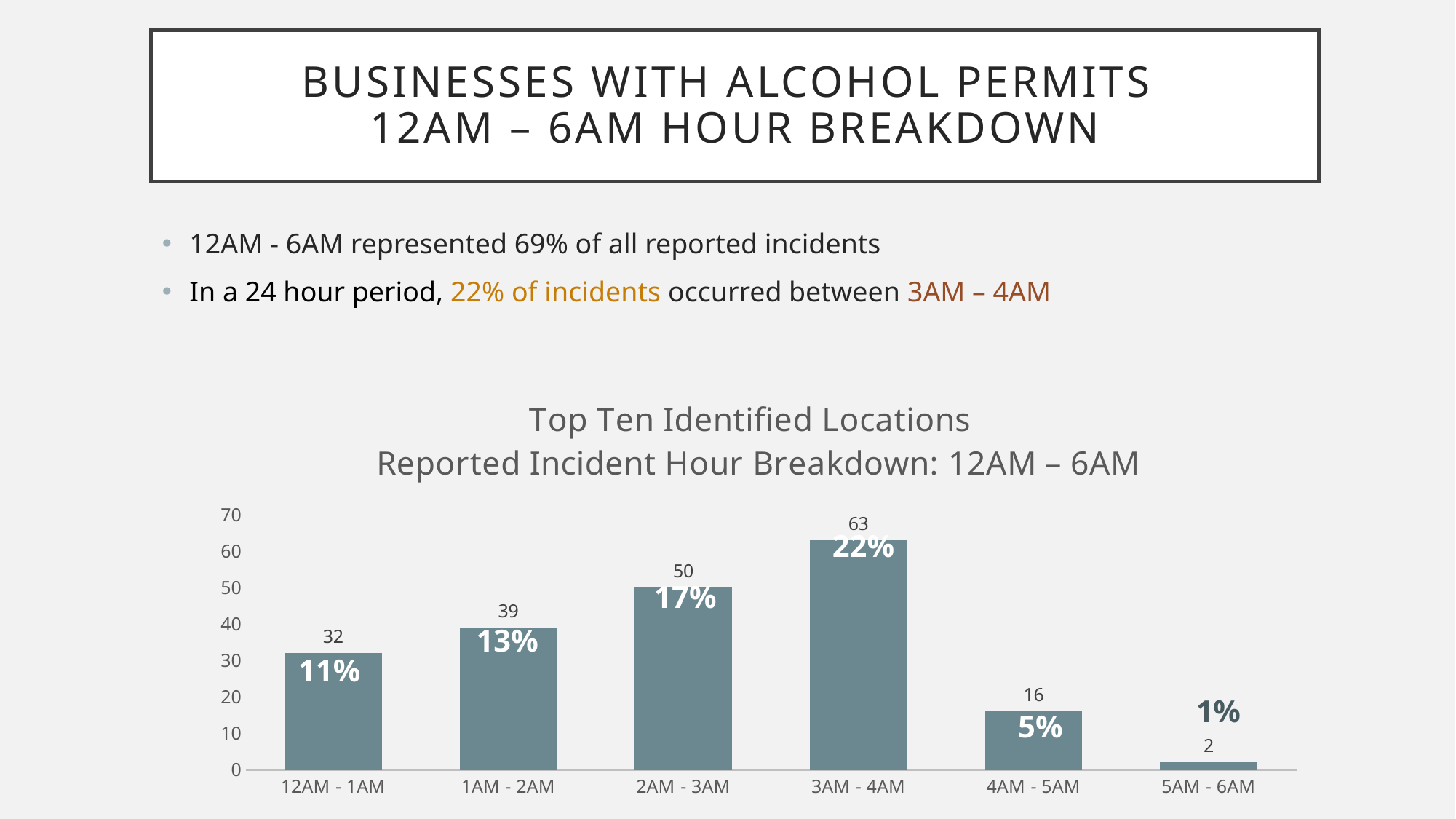
Which hour has the highest value? 3AM - 4AM Which is larger, the value for 1AM - 2AM or the value for 12AM - 1AM? 1AM - 2AM What is the difference between the values for 1AM - 2AM and 4AM - 5AM? 23 What percentage label is shown on the 2AM - 3AM bar? 17% Do the values rise or fall from 3AM - 4AM to 5AM - 6AM? Fall What is the value for 12AM - 1AM? 32 How many hour categories are shown on the x axis? 6 What is the difference between the values for 3AM - 4AM and 2AM - 3AM? 13 Which hour has the lowest value? 5AM - 6AM What is the value for 3AM - 4AM? 63 What is the title of the chart? Top Ten Identified Locations Reported Incident Hour Breakdown: 12AM – 6AM What kind of chart is shown? Bar chart